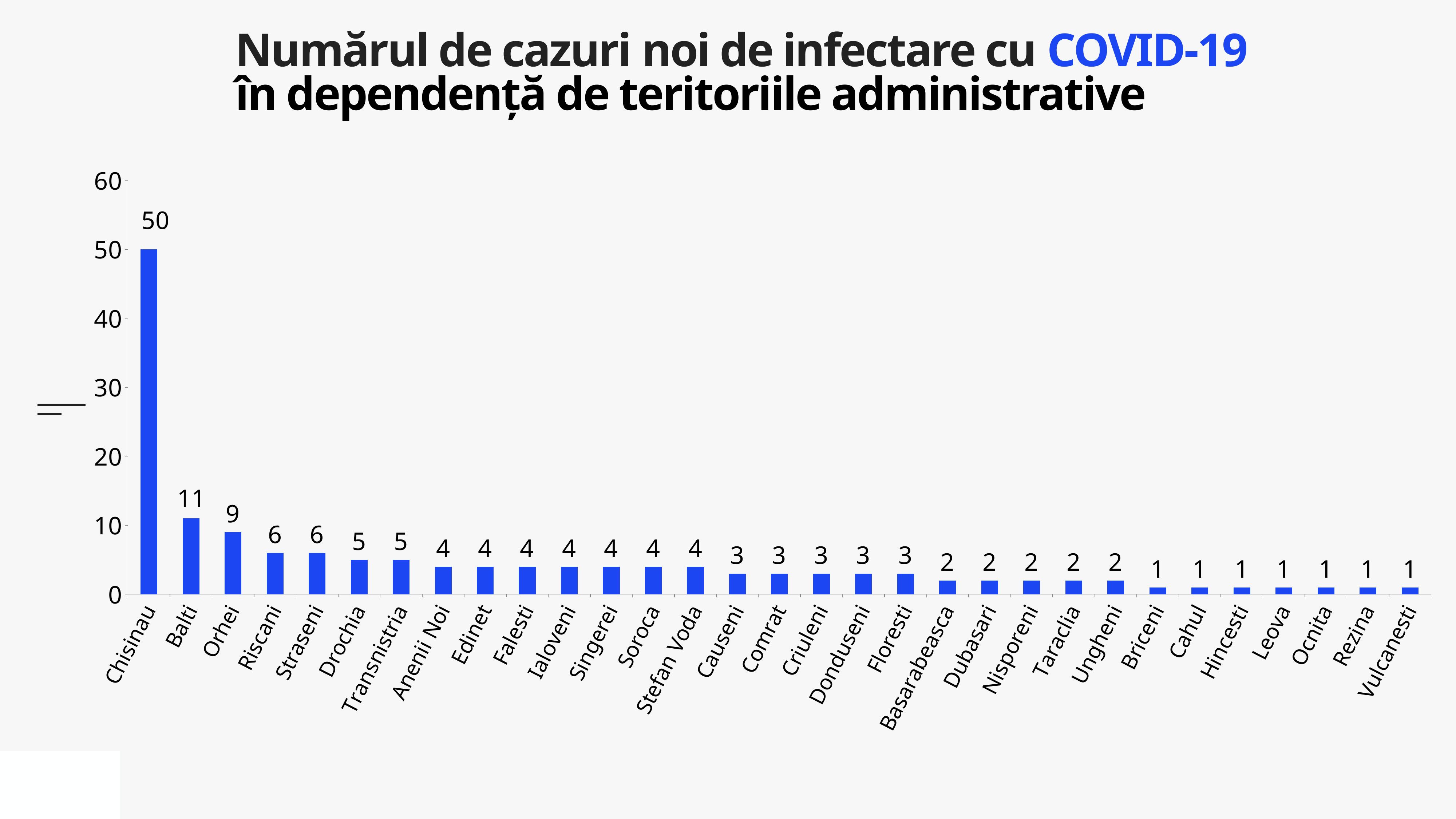
What kind of chart is shown on the slide? bar chart Is the value for Chisinau greater or less than 40? greater How many administrative territories are shown on the x axis? 31 Which territory has the highest number of new cases? Chisinau What is the value for Orhei? 9 What is the value for Transnistria? 5 How many new COVID-19 cases are shown for Chisinau? 50 Which has a larger value, Drochia or Ungheni? Drochia What is the difference between the values for Chisinau and Balti? 39 What is the difference between the values for Orhei and Riscani? 3 What is the value for Balti? 11 What is the value for Floresti? 3